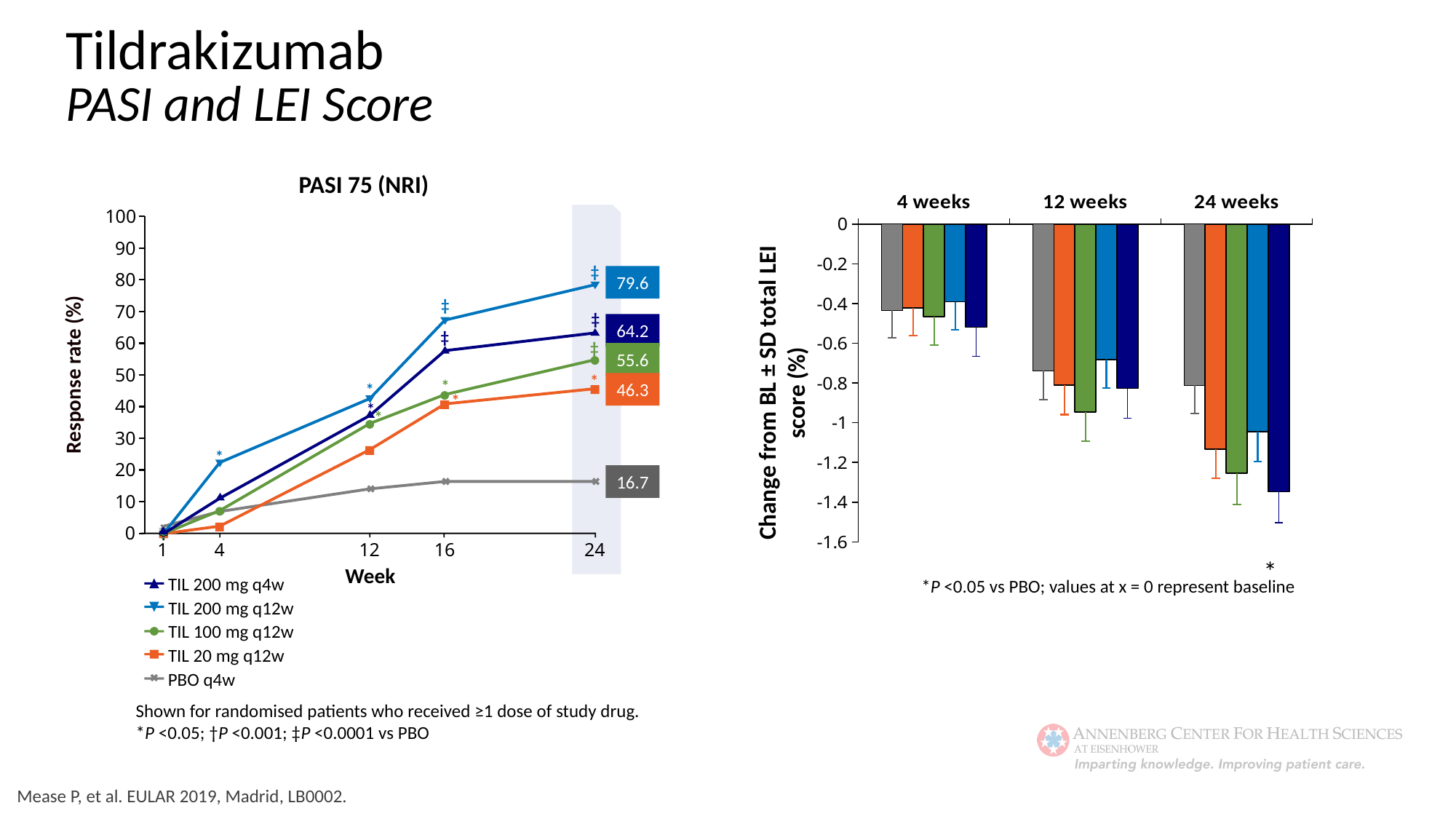
In the PASI 75 (NRI) chart, what is the response rate for TIL 200 mg q12w at week 24? 79.6 In the PASI 75 (NRI) chart, which group has the lowest response rate at week 24? PBO q4w In the PASI 75 (NRI) chart, what is the response rate for PBO q4w at week 24? 16.7 What kind of chart is the chart on the right showing change from BL in total LEI score? bar chart In the PASI 75 (NRI) chart, what is the difference between the week 24 response rates of TIL 200 mg q12w and PBO q4w? 62.9 In the PASI 75 (NRI) chart, which has the higher response rate at week 24: TIL 100 mg q12w or TIL 20 mg q12w? TIL 100 mg q12w In the PASI 75 (NRI) chart, what is the response rate for TIL 200 mg q4w at week 24? 64.2 In the PASI 75 (NRI) chart, what is the difference between the week 24 response rates of TIL 200 mg q4w and TIL 100 mg q12w? 8.6 In the PASI 75 (NRI) chart, which treatment group has the highest response rate at week 24? TIL 200 mg q12w In the PASI 75 (NRI) chart, does the response rate for TIL 200 mg q12w rise or fall from week 1 to week 24? rise In the chart on the right showing change from BL in total LEI score, how many time-point groups are shown on the x axis? 3 How many series does the legend of the PASI 75 (NRI) chart list? 5